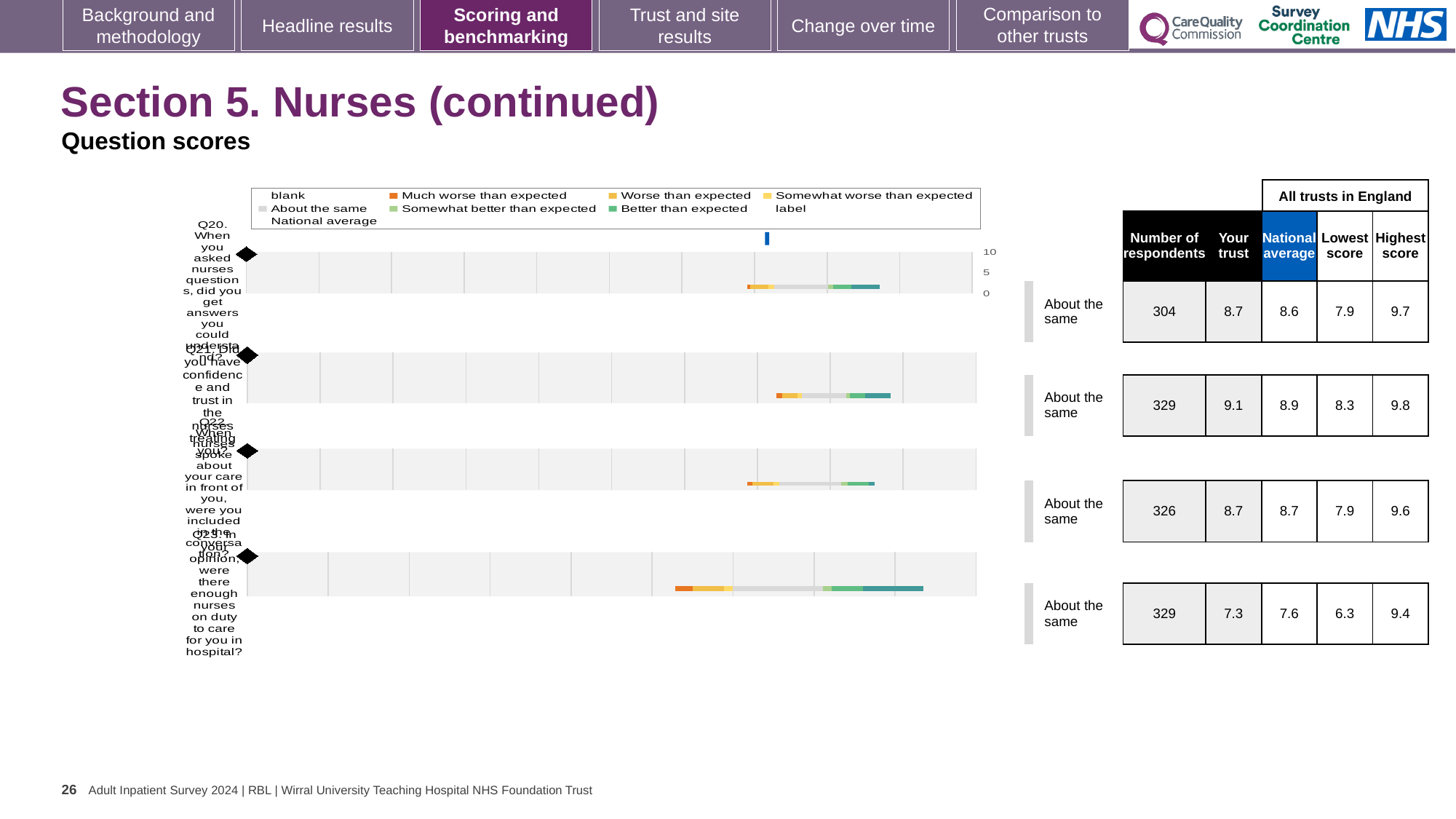
How many questions (Q20 to Q23) are plotted in the chart? 4 What colour represents 'Much worse than expected' in the chart legend? orange Is the 'Your trust' score for Q23 greater or less than 5? greater What is the national average score for Q23? 7.6 For Q20, which is larger: the 'Your trust' score or the national average? Your trust What benchmark category is shown for Q22? About the same Which question has the highest 'Your trust' score? Q21 For Q23, what is the difference between the highest score and the lowest score across all trusts in England? 3.1 What type of chart is used to show the question scores on this slide? bar chart Which question has the lowest 'Your trust' score? Q23 What is the 'Your trust' score for Q21? 9.1 What is the number of respondents for Q20 in the table next to the chart? 304